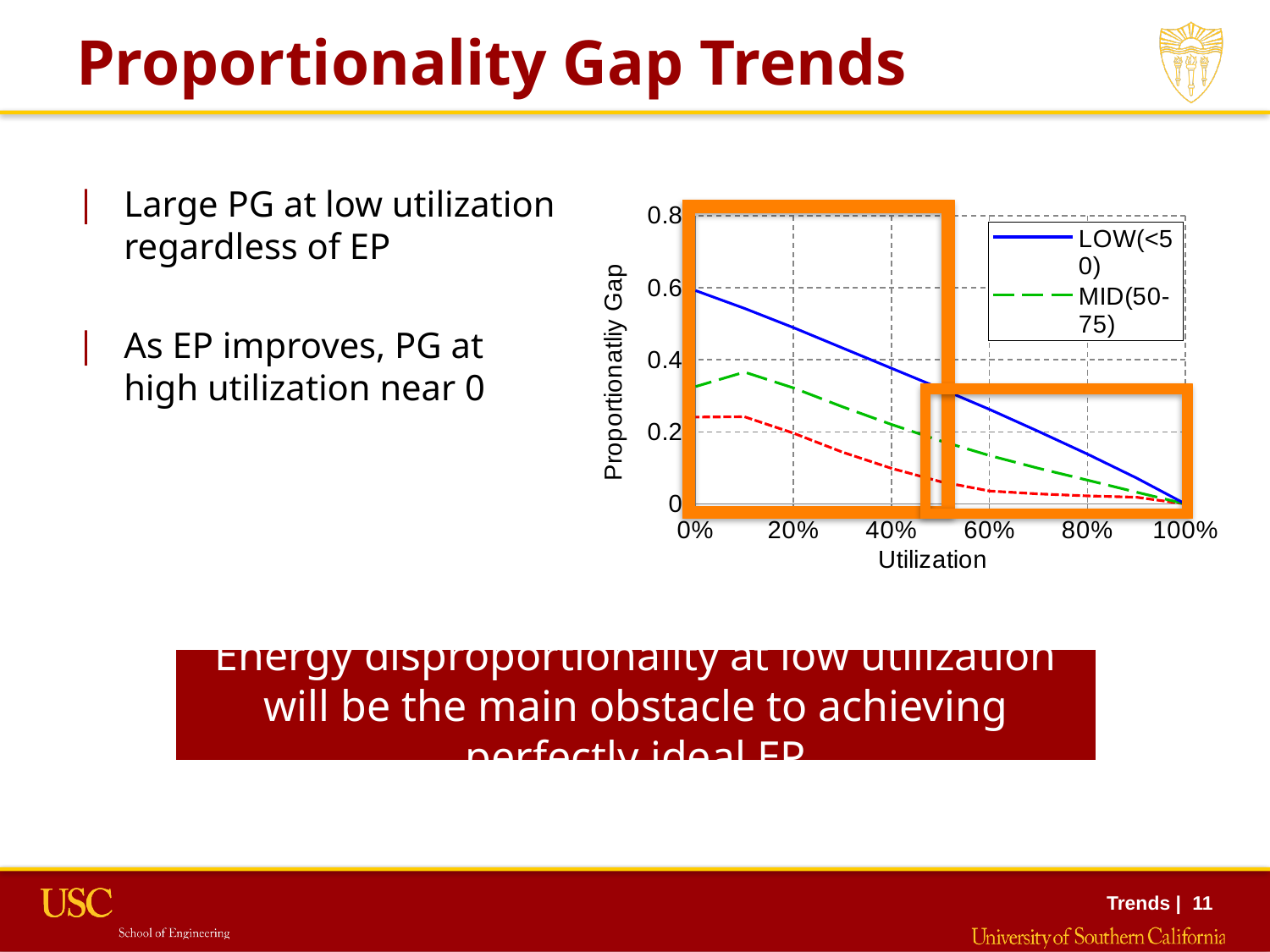
At 40% utilization, which line is higher, LOW(<50) or MID(50-75)? LOW(<50) What kind of chart is shown on the slide? line chart Is the value of the MID(50-75) line at 0% utilization greater or less than 0.2? greater Is the value of the LOW(<50) line at 100% utilization greater or less than 0.2? less How many series does the chart's legend list? 2 Which series has the highest proportionality gap at 0% utilization? LOW(<50) Is the value of the LOW(<50) line at 60% utilization greater or less than 0.4? less Does the LOW(<50) line rise or fall as utilization increases from 0% to 100%? fall How many lines are plotted on the chart? 3 What is the label of the x axis of the chart? Utilization